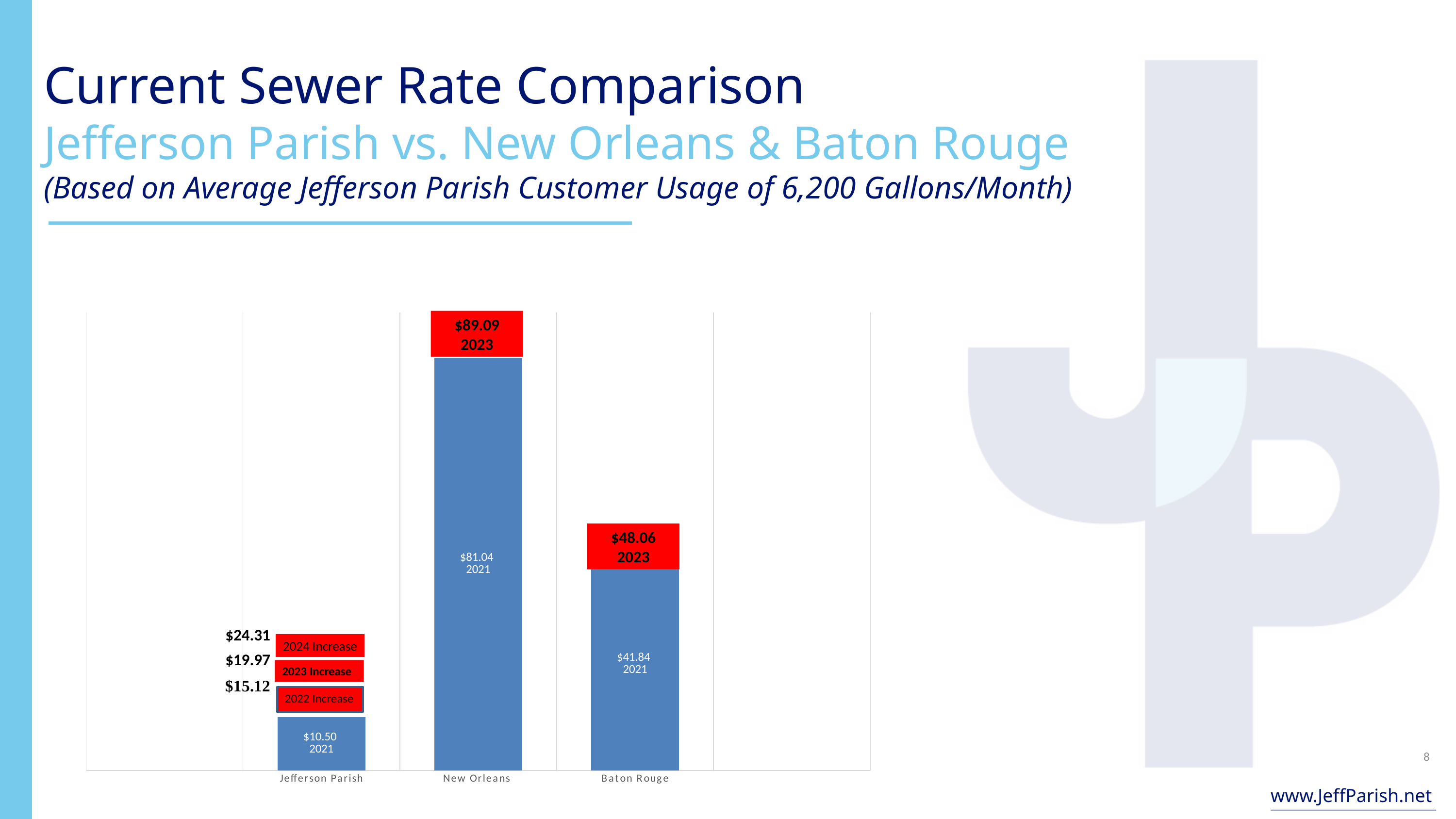
How many categories are shown on the x axis of the chart? 3 What is the 2023 sewer rate for Baton Rouge? $48.06 What is the Jefferson Parish sewer rate after the 2024 increase? $24.31 Which category has the highest 2023 sewer rate? New Orleans Which category had the lowest 2021 sewer rate? Jefferson Parish What kind of chart is shown on the slide? bar chart What was the 2021 sewer rate for New Orleans? $81.04 What is the difference between the 2023 sewer rates of New Orleans and Baton Rouge? $41.03 What was the 2021 sewer rate for Jefferson Parish? $10.50 Which is larger: the Baton Rouge 2021 rate or the Jefferson Parish rate after the 2024 increase? Baton Rouge 2021 rate What was the 2021 sewer rate for Baton Rouge? $41.84 What is the 2023 sewer rate for New Orleans? $89.09